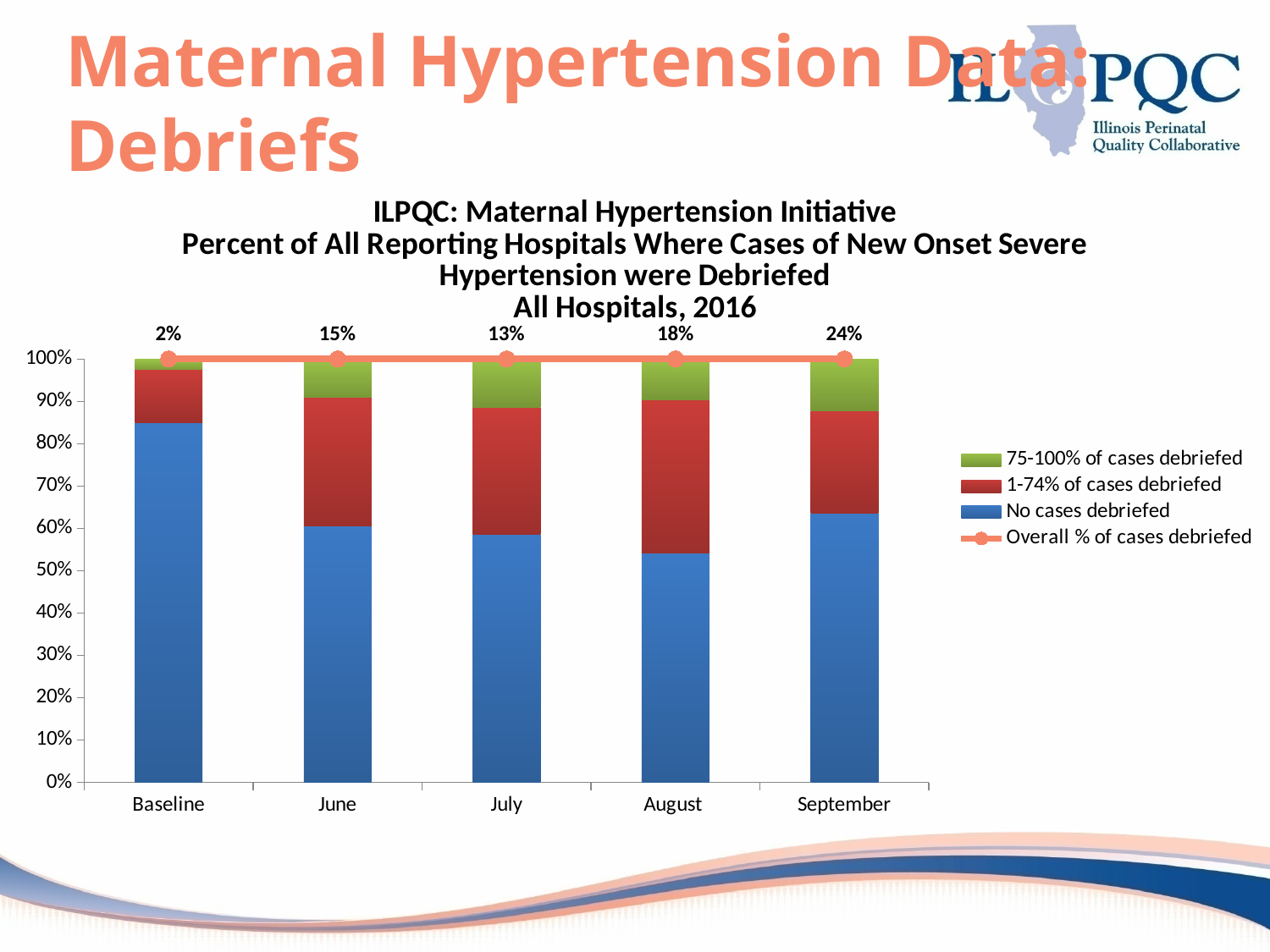
Which period has the lowest overall % of cases debriefed? Baseline Which has a higher overall % of cases debriefed, July or August? August Which month has the highest overall % of cases debriefed? September How many time periods are shown on the x axis? 5 Is the value for 'No cases debriefed' at Baseline greater or less than 80%? greater What is the overall % of cases debriefed in September? 24% What kind of chart is this? Stacked bar chart with a line Is the value for 'No cases debriefed' in August greater or less than 60%? less What is the overall % of cases debriefed at Baseline? 2% What is the difference in overall % of cases debriefed between September and Baseline? 22 percentage points What is the overall % of cases debriefed in July? 13% How many series does the legend list? 4